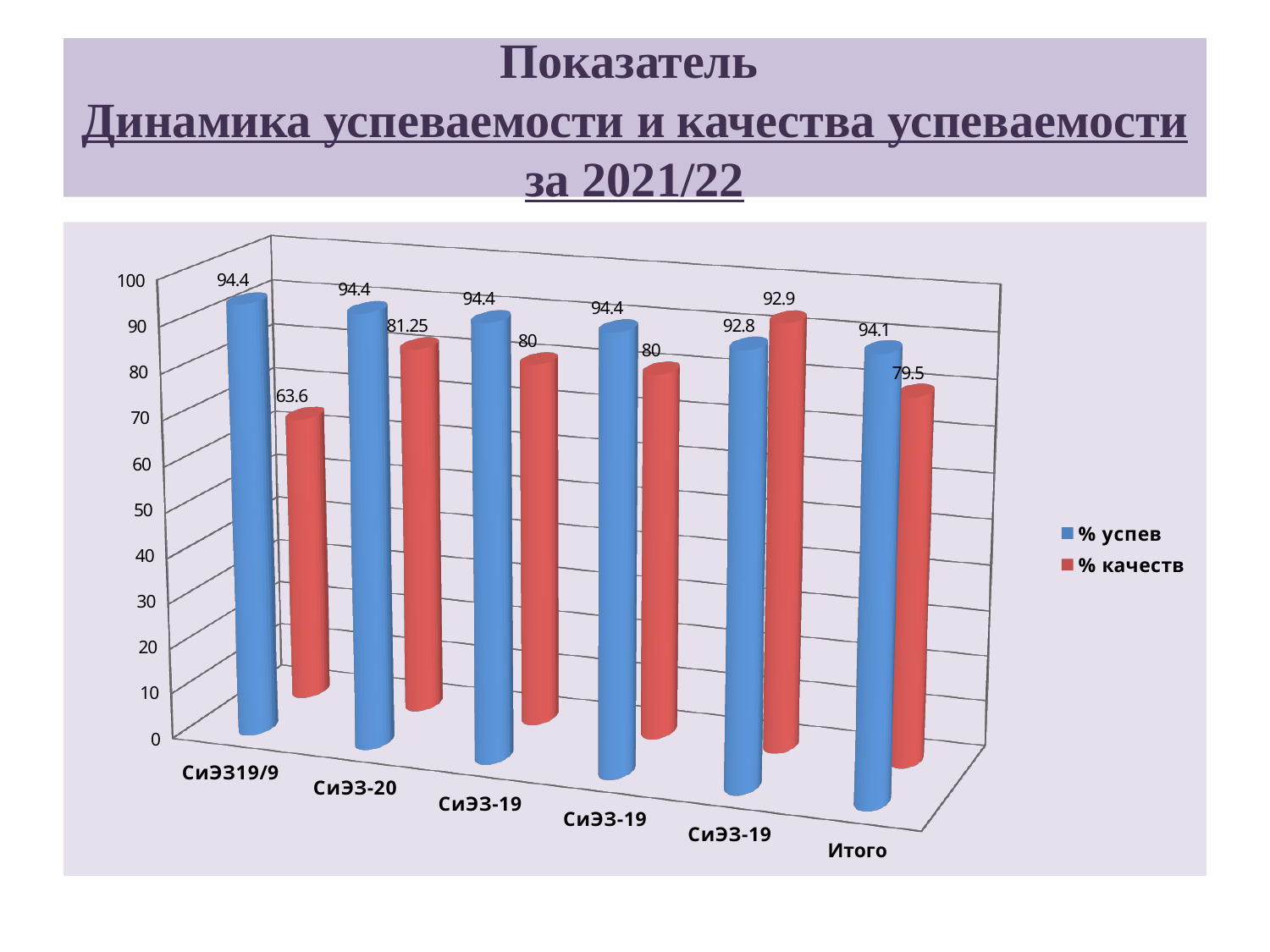
What kind of chart is shown on the slide? Bar chart What is the difference between the % успев and % качеств values for Итого? 14.6 Which category has the lowest % качеств value? СиЭЗ19/9 What is the % качеств value for СиЭЗ-20? 81.25 What is the % качеств value for Итого? 79.5 What is the highest % качеств value shown on the chart? 92.9 What is the difference between the % успев and % качеств values for СиЭЗ19/9? 30.8 What is the % качеств value for СиЭЗ19/9? 63.6 What is the % успев value for Итого? 94.1 How many categories are shown on the x axis? 6 For Итого, which is larger: % успев or % качеств? % успев How many series does the legend list? 2